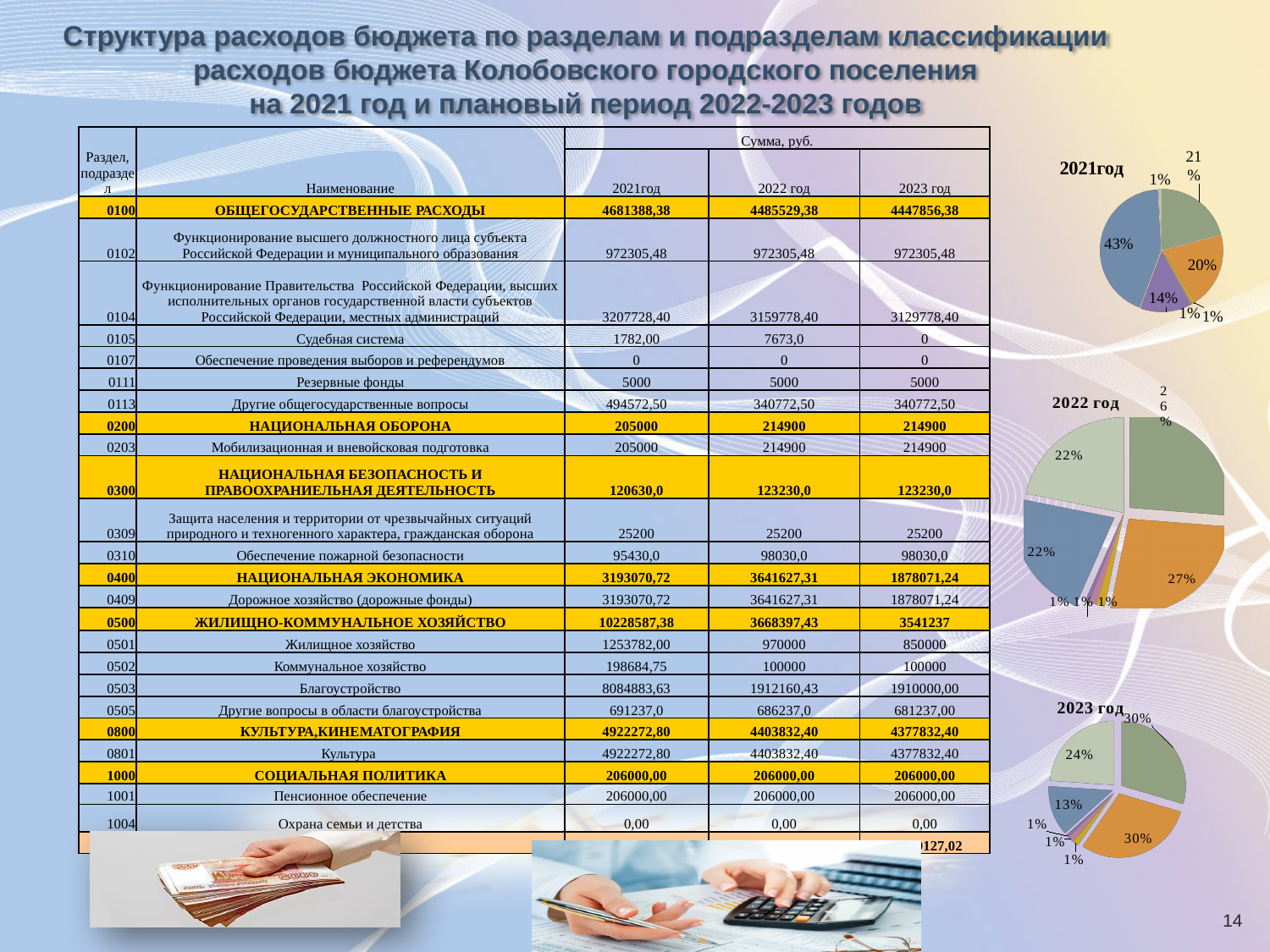
In the "2022 год" pie chart, how many slices are labelled 22%? 2 How many pie charts are shown on the slide? 3 In the "2021год" pie chart, what is the share of the smallest slices? 1% In the "2021год" pie chart, what is the share of the largest slice? 43% In the "2023 год" pie chart, how many slices are labelled 30%? 2 What kind of chart is the chart titled "2021год"? pie chart In the "2022 год" pie chart, what is the share of the largest slice? 27% What are the titles of the three pie charts on the slide? 2021год, 2022 год, 2023 год In the "2023 год" pie chart, what is the share of the smallest slices? 1% In the "2021год" pie chart, how many slices are there? 7 In the "2021год" pie chart, what is the difference between the largest slice (43%) and the 21% slice? 22 percentage points